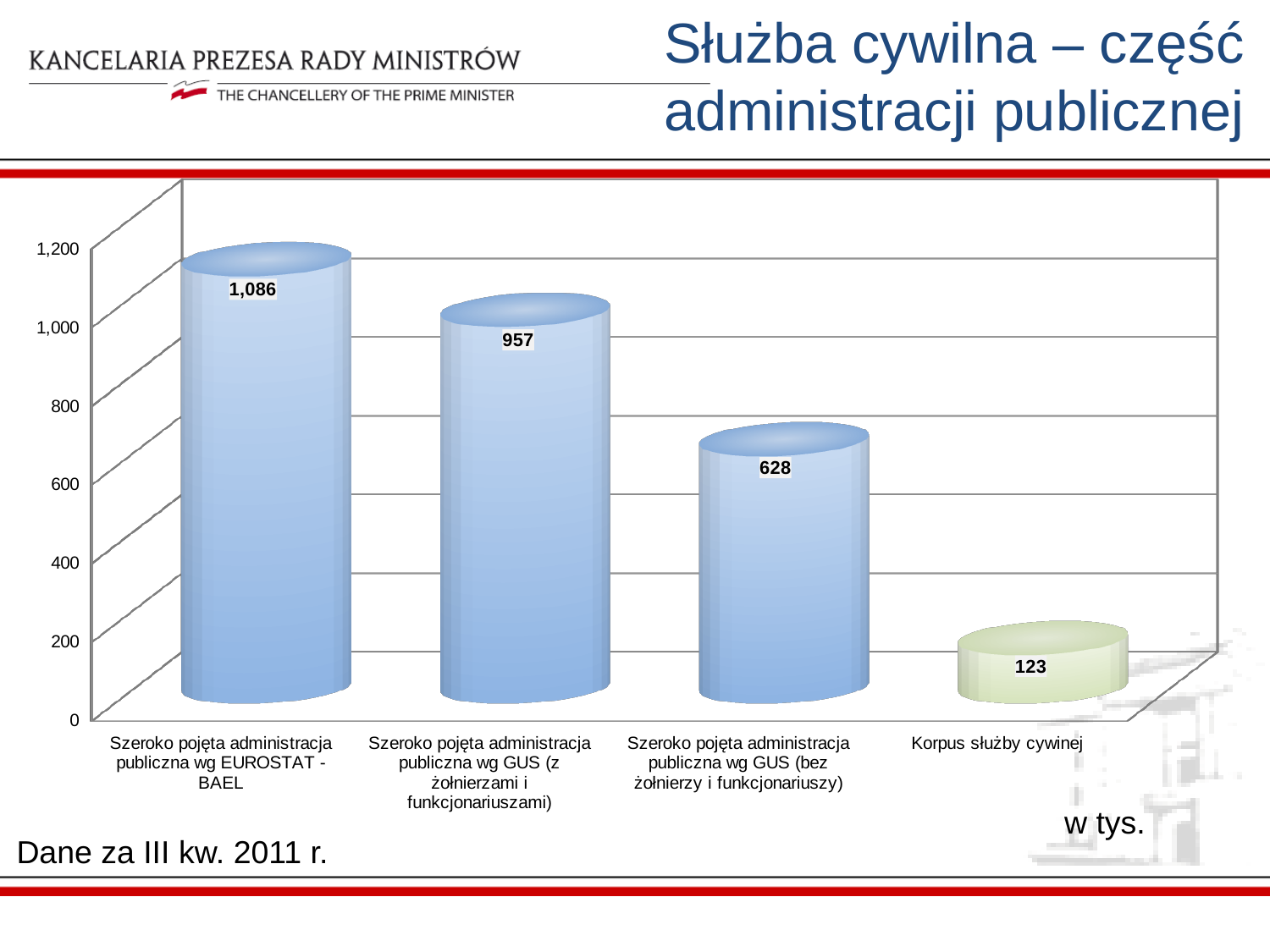
What is the difference between the two GUS categories (with and without soldiers and officers)? 329 Which category has the highest value? Szeroko pojęta administracja publiczna wg EUROSTAT - BAEL What is the value for 'Szeroko pojęta administracja publiczna wg GUS (z żołnierzami i funkcjonariuszami)'? 957 What is the value for 'Szeroko pojęta administracja publiczna wg EUROSTAT - BAEL'? 1,086 What kind of chart is shown on the slide? Bar chart What is the value for 'Korpus służby cywilnej'? 123 Do the values rise or fall from left to right along the x axis? Fall How many categories are shown in the chart? 4 Which category has the lowest value? Korpus służby cywinej What is the difference between the value for 'Szeroko pojęta administracja publiczna wg EUROSTAT - BAEL' and 'Korpus służby cywilnej'? 963 Which is larger: the value for 'Szeroko pojęta administracja publiczna wg GUS (z żołnierzami i funkcjonariuszami)' or 'Szeroko pojęta administracja publiczna wg GUS (bez żołnierzy i funkcjonariuszy)'? Szeroko pojęta administracja publiczna wg GUS (z żołnierzami i funkcjonariuszami) What is the value for 'Szeroko pojęta administracja publiczna wg GUS (bez żołnierzy i funkcjonariuszy)'? 628